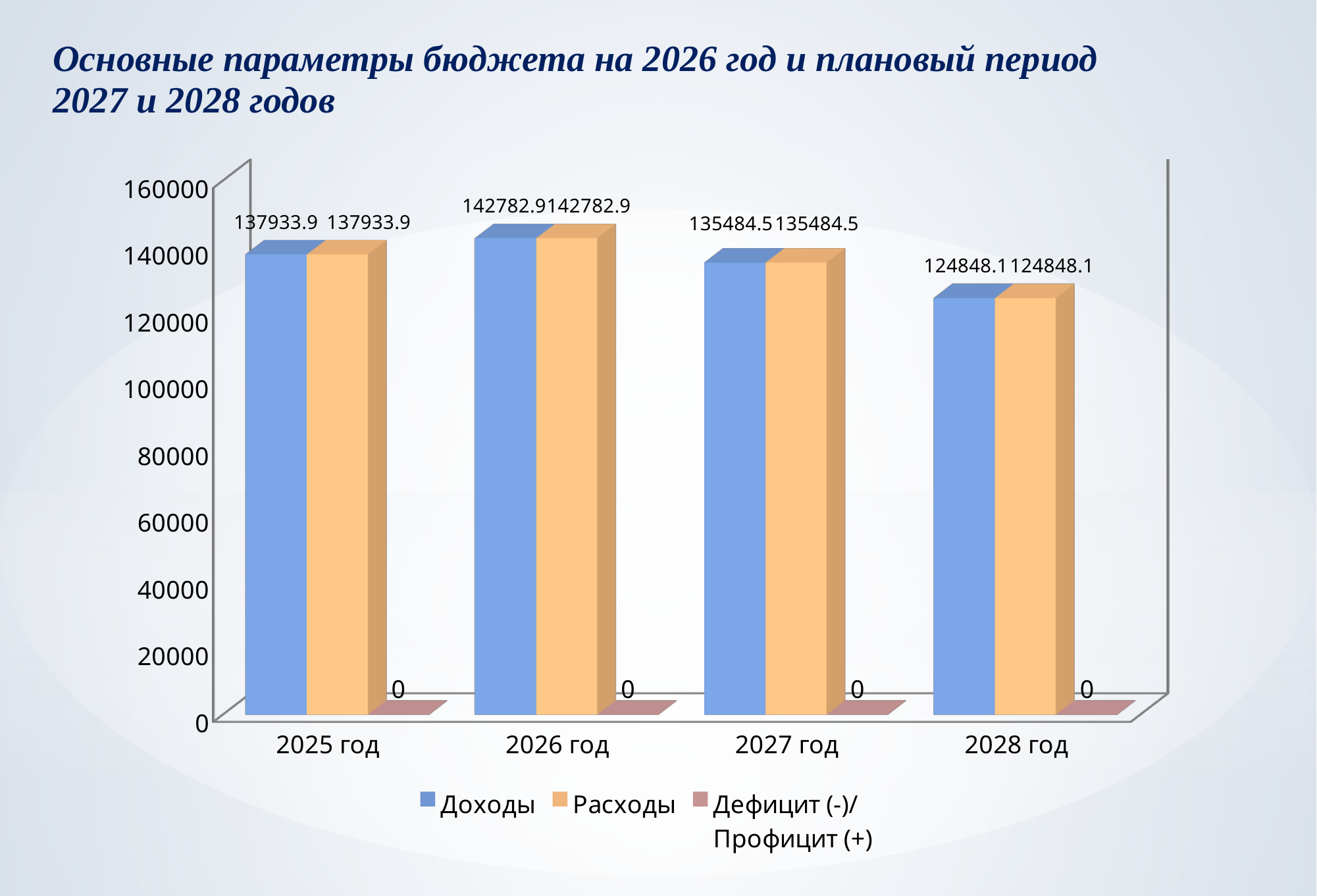
What kind of chart is shown on the slide? bar chart What is the value of Дефицит (-)/Профицит (+) for 2027 год? 0 What is the difference between Доходы in 2026 год and Доходы in 2028 год? 17934.8 In which year is Доходы the highest? 2026 год What is the value of Расходы for 2028 год? 124848.1 Is the value of Доходы for 2027 год greater or less than 140000? less In which year is Расходы the lowest? 2028 год Which is larger: Расходы in 2025 год or Расходы in 2027 год? 2025 год How many years are shown on the x axis? 4 What is the value of Доходы for 2026 год? 142782.9 What is the value of Доходы for 2025 год? 137933.9 How many series does the legend list? 3